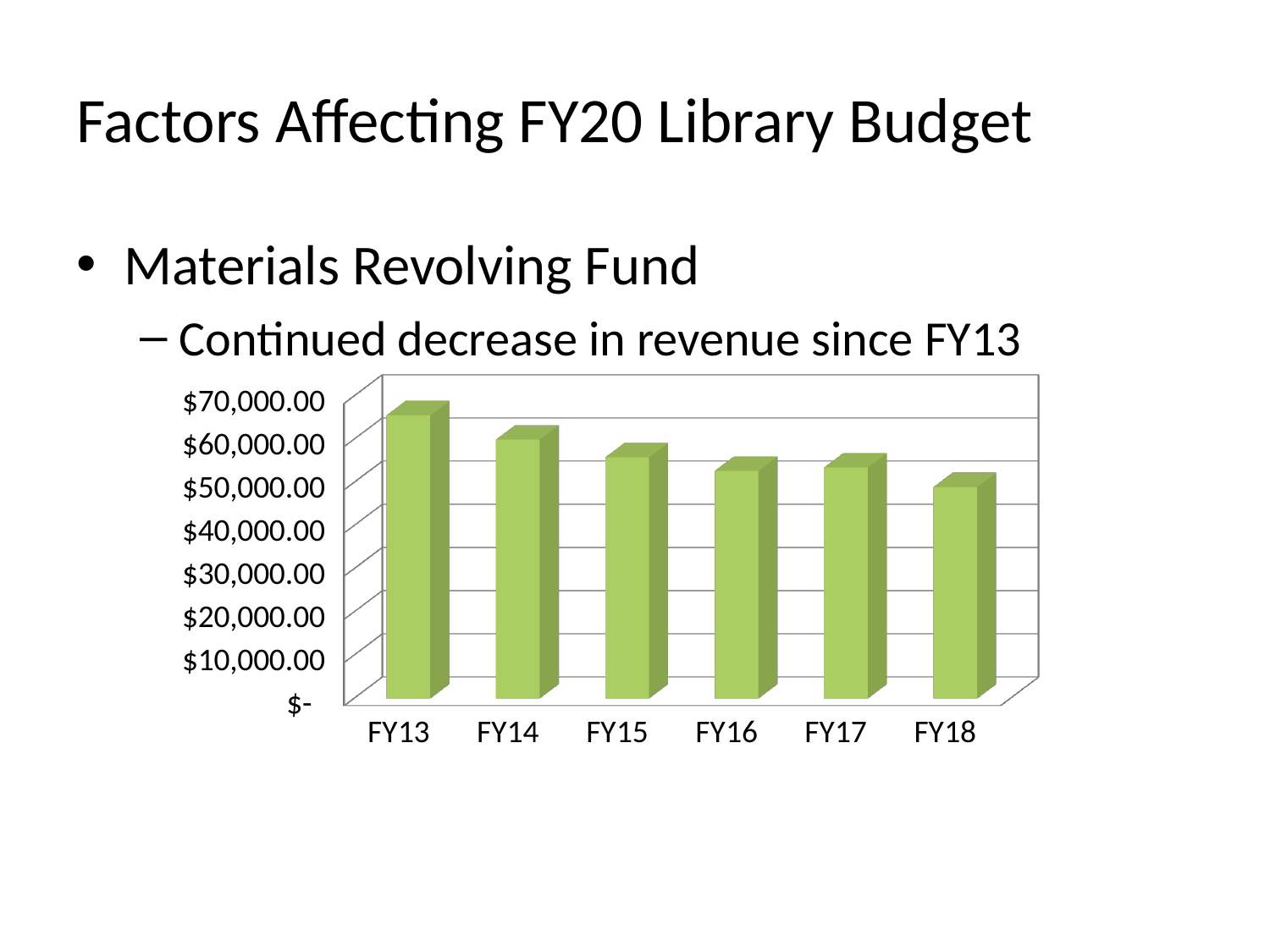
How many fiscal years are plotted on the chart? 6 Do the values generally rise or fall from FY13 to FY18? fall Is the value for FY14 greater or less than $50,000.00? greater Which is larger, the value for FY13 or the value for FY18? FY13 What kind of chart is shown on the slide? bar chart Which fiscal year has the highest value on the chart? FY13 Is the value for FY16 greater or less than $60,000.00? less Is the value for FY13 greater or less than $60,000.00? greater Which is larger, the value for FY14 or the value for FY16? FY14 What colour are the bars on the chart? green Which fiscal year has the lowest value on the chart? FY18